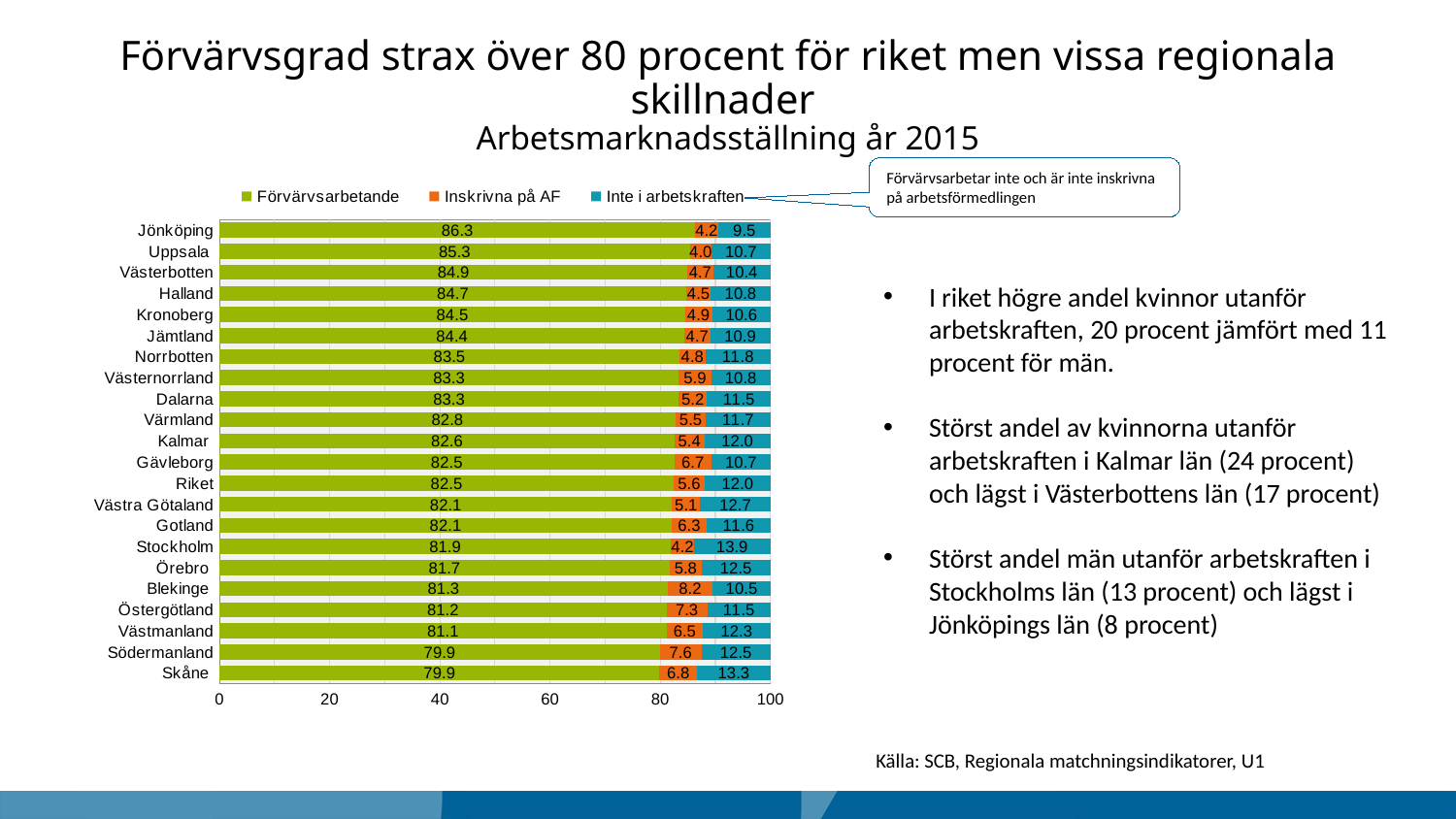
How many regions are shown in the chart? 22 Which has the larger Inskrivna på AF value, Kalmar or Gävleborg? Gävleborg What is the Förvärvsarbetande value for Jönköping? 86.3 What is the Inte i arbetskraften value for Stockholm? 13.9 What kind of chart is shown on the slide? Stacked bar chart Which region has the highest Förvärvsarbetande value? Jönköping What is the Inskrivna på AF value for Blekinge? 8.2 How many series does the legend list? 3 What is the difference between the Förvärvsarbetande values for Jönköping and Skåne? 6.4 What is the Förvärvsarbetande value for Riket? 82.5 Which region has the highest Inte i arbetskraften value? Stockholm Which region has the lowest Inskrivna på AF value? Uppsala